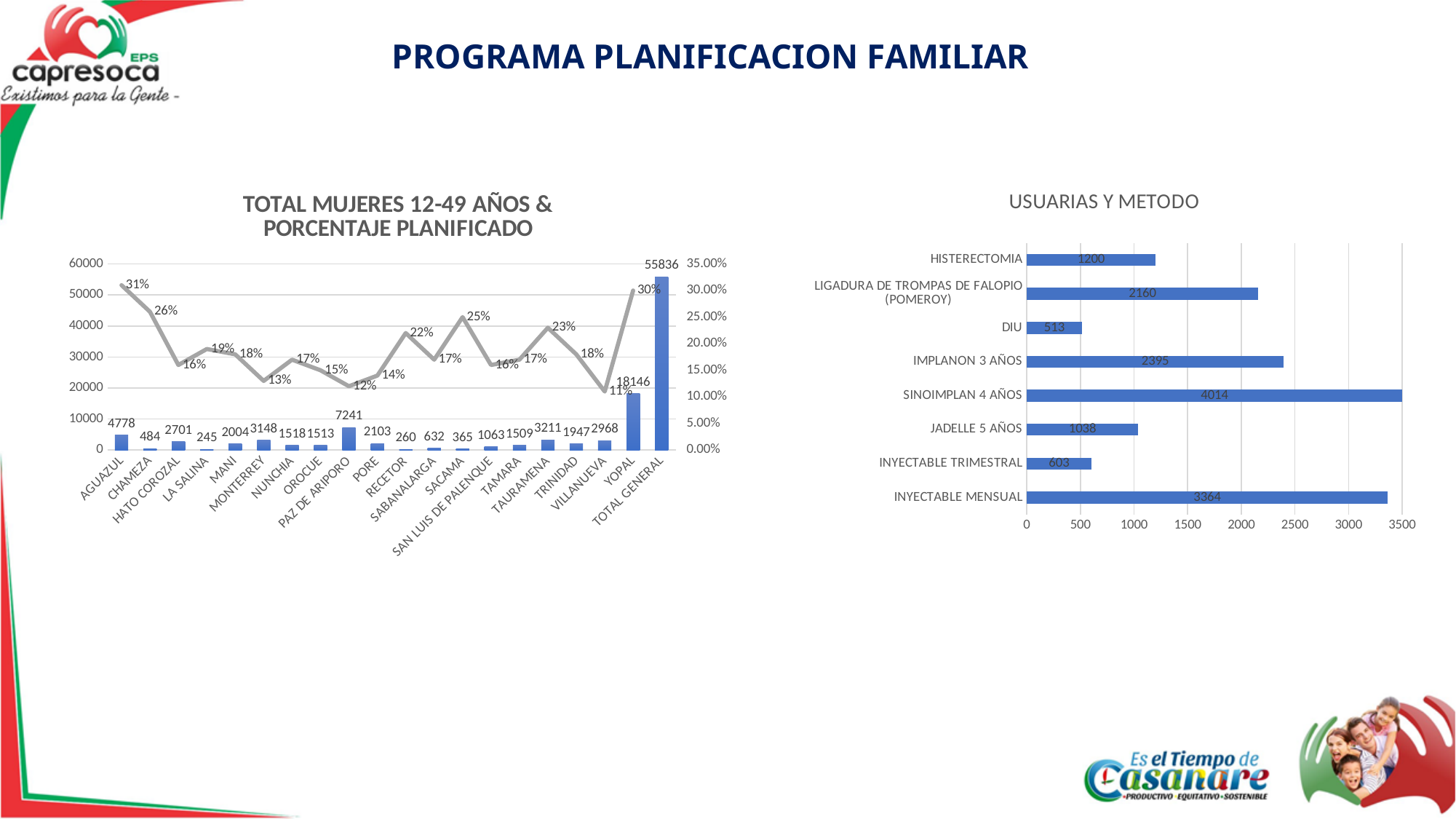
In the 'USUARIAS Y METODO' chart, which method has the highest value? SINOIMPLAN 4 AÑOS In the 'TOTAL MUJERES 12-49 AÑOS & PORCENTAJE PLANIFICADO' chart, which municipality has the lowest percentage on the line? VILLANUEVA In the 'USUARIAS Y METODO' chart, how many methods are listed? 8 In the 'TOTAL MUJERES 12-49 AÑOS & PORCENTAJE PLANIFICADO' chart, which has a larger bar value, PAZ DE ARIPORO or TAURAMENA? PAZ DE ARIPORO In the 'USUARIAS Y METODO' chart, what is the difference between INYECTABLE MENSUAL and INYECTABLE TRIMESTRAL? 2761 In the 'USUARIAS Y METODO' chart, which method has the lowest value? DIU What type of chart is 'USUARIAS Y METODO'? Bar chart In the 'TOTAL MUJERES 12-49 AÑOS & PORCENTAJE PLANIFICADO' chart, which municipality (excluding TOTAL GENERAL) has the lowest bar value? LA SALINA In the 'TOTAL MUJERES 12-49 AÑOS & PORCENTAJE PLANIFICADO' chart, what percentage is shown for AGUAZUL? 31% In the 'USUARIAS Y METODO' chart, what is the value for SINOIMPLAN 4 AÑOS? 4014 In the 'TOTAL MUJERES 12-49 AÑOS & PORCENTAJE PLANIFICADO' chart, what is the bar value for YOPAL? 18146 In the 'TOTAL MUJERES 12-49 AÑOS & PORCENTAJE PLANIFICADO' chart, what is the difference between the bar values for YOPAL and PAZ DE ARIPORO? 10905